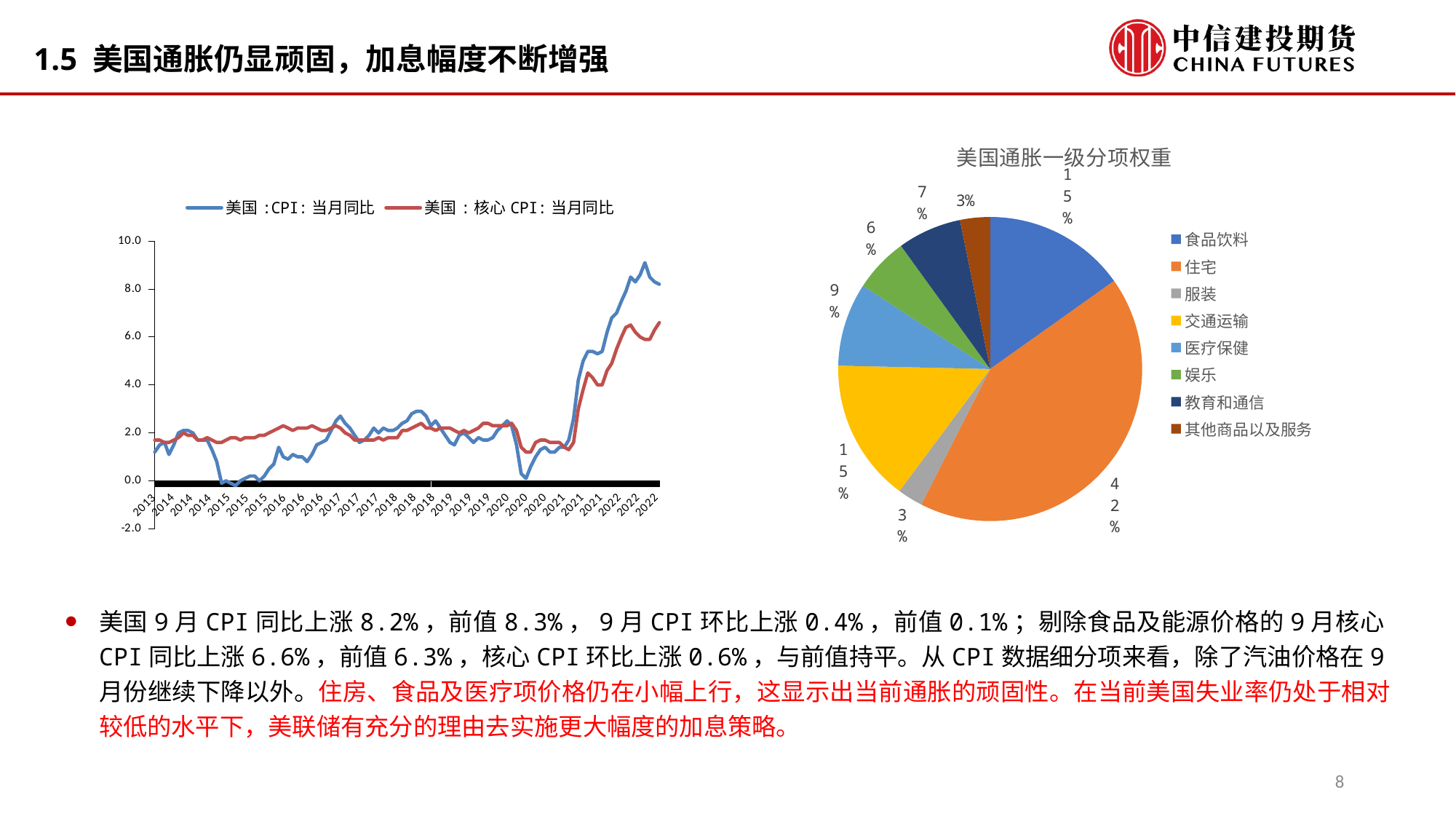
In the pie chart 美国通胀一级分项权重, which category has the largest share? 住宅 In the pie chart 美国通胀一级分项权重, which has the larger share, 医疗保健 or 娱乐? 医疗保健 In the line chart on the left, is the latest 2022 value of 美国:CPI:当月同比 greater or less than 8.0? greater In the pie chart 美国通胀一级分项权重, how many categories are shown? 8 What kind of chart is the chart on the right titled 美国通胀一级分项权重? pie chart In the line chart on the left, do the values of 美国:CPI:当月同比 rise or fall from 2020 to 2022? rise In the pie chart 美国通胀一级分项权重, how much larger is the share of 住宅 than the share of 食品饮料? 27% In the pie chart 美国通胀一级分项权重, what share does 住宅 have? 42% How many series does the legend of the line chart on the left list? 2 What kind of chart is the chart on the left showing 美国:CPI:当月同比 and 美国:核心CPI:当月同比? line chart In the pie chart 美国通胀一级分项权重, what share does 教育和通信 have? 7% In the pie chart 美国通胀一级分项权重, what share does 医疗保健 have? 9%